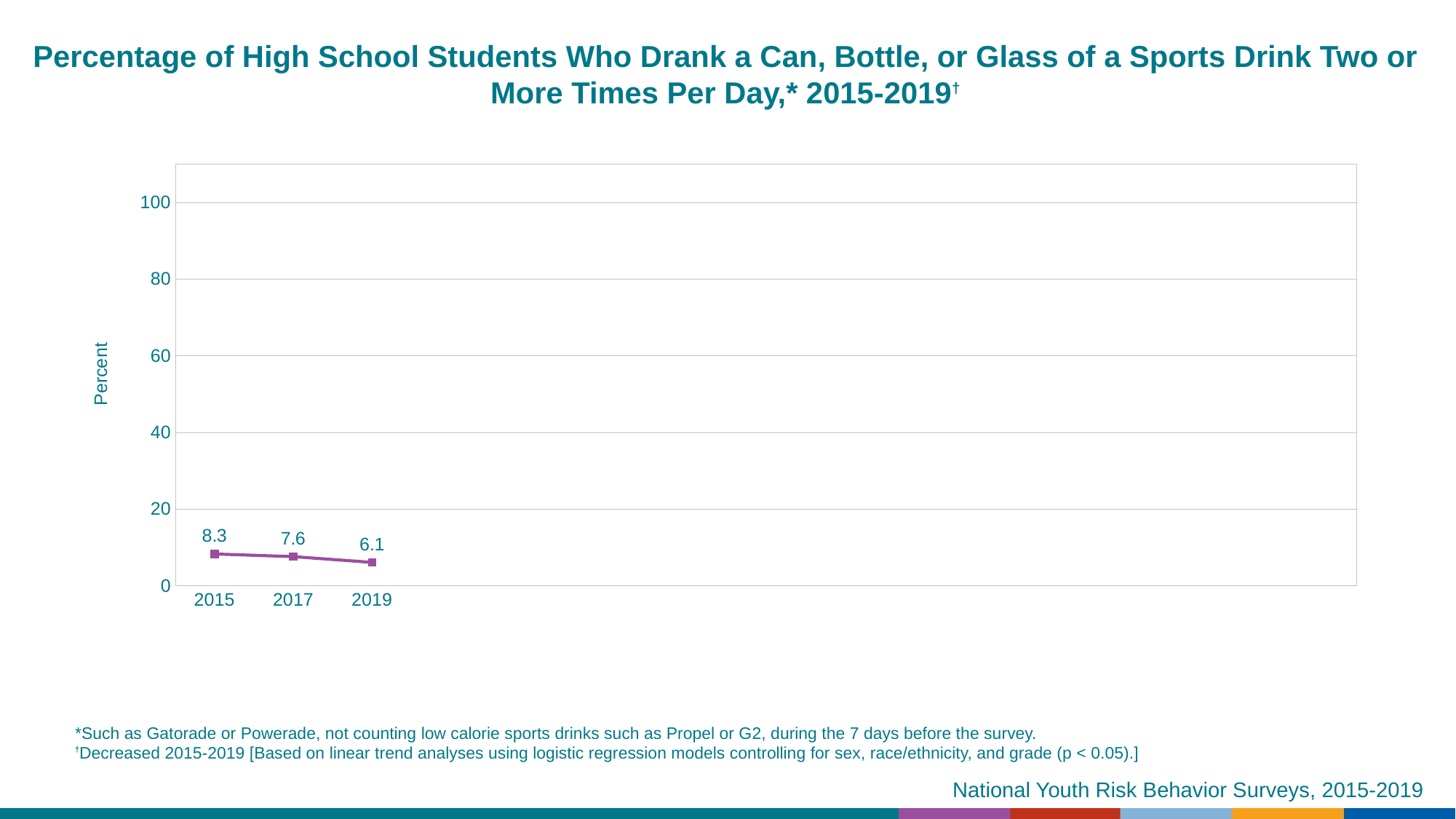
Is the value for 2019 greater or less than 20? less Do the values rise or fall from 2015 to 2019? fall What is the difference between the 2015 value and the 2019 value? 2.2 What percentage of high school students drank a sports drink two or more times per day in 2015? 8.3 What is the difference between the 2017 value and the 2019 value? 1.5 Which year has the highest value on the chart? 2015 What kind of chart is shown on the slide? line chart How many years are plotted on the chart? 3 Which year has the lowest value on the chart? 2019 Which is larger, the value for 2015 or the value for 2017? 2015 What is the value plotted for 2019? 6.1 What is the value plotted for 2017? 7.6